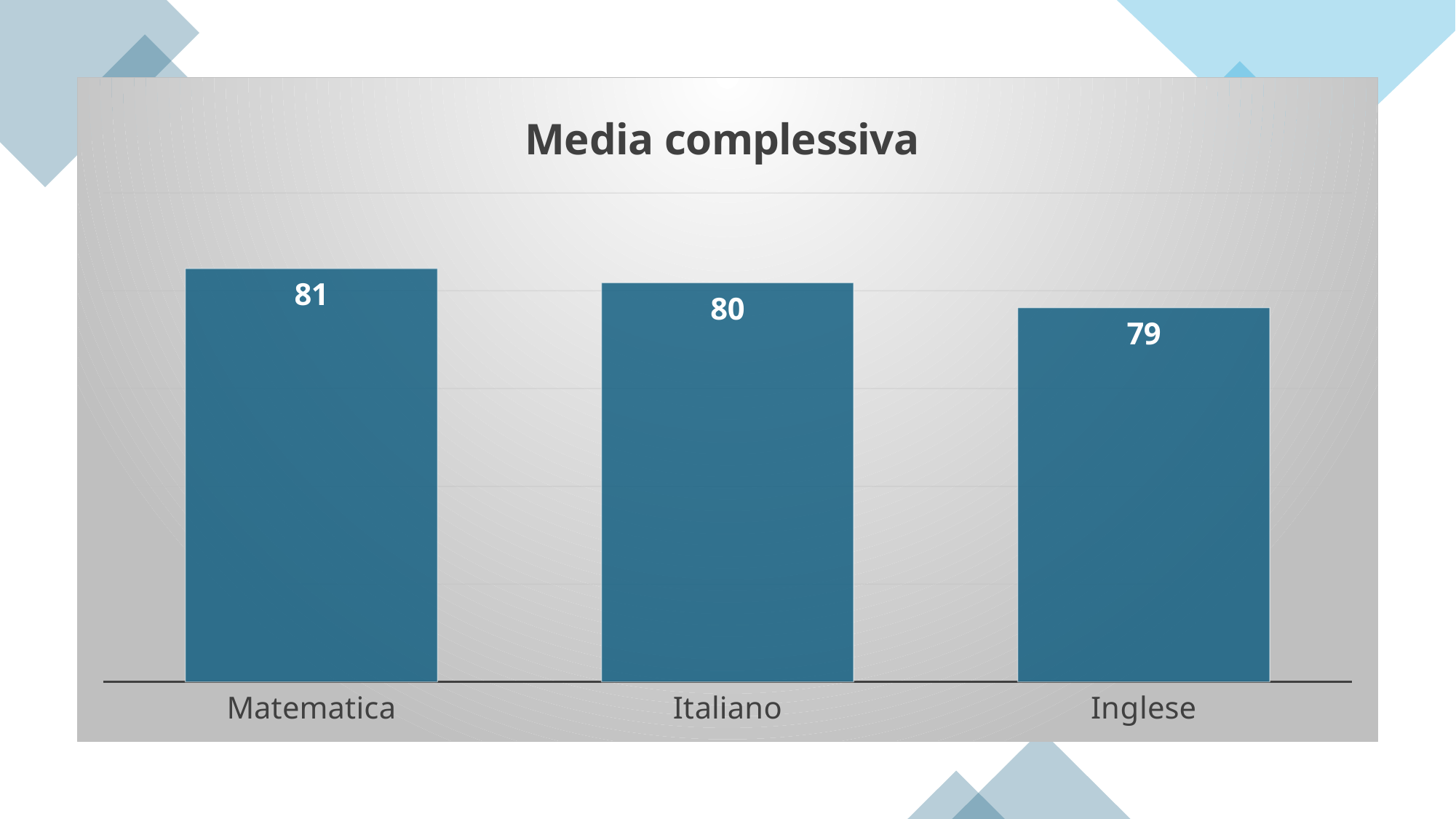
What is the value for Inglese? 79 Which category has the lowest value? Inglese What is the difference between the values for Italiano and Inglese? 1 Do the values rise or fall from left to right along the x axis? Fall What is the value for Italiano? 80 Which category has the highest value? Matematica What is the value for Matematica? 81 How many categories are shown in the chart? 3 What is the difference between the values for Matematica and Inglese? 2 What kind of chart is shown on the slide? Bar chart What is the title of the chart? Media complessiva Which is larger, the value for Matematica or the value for Italiano? Matematica